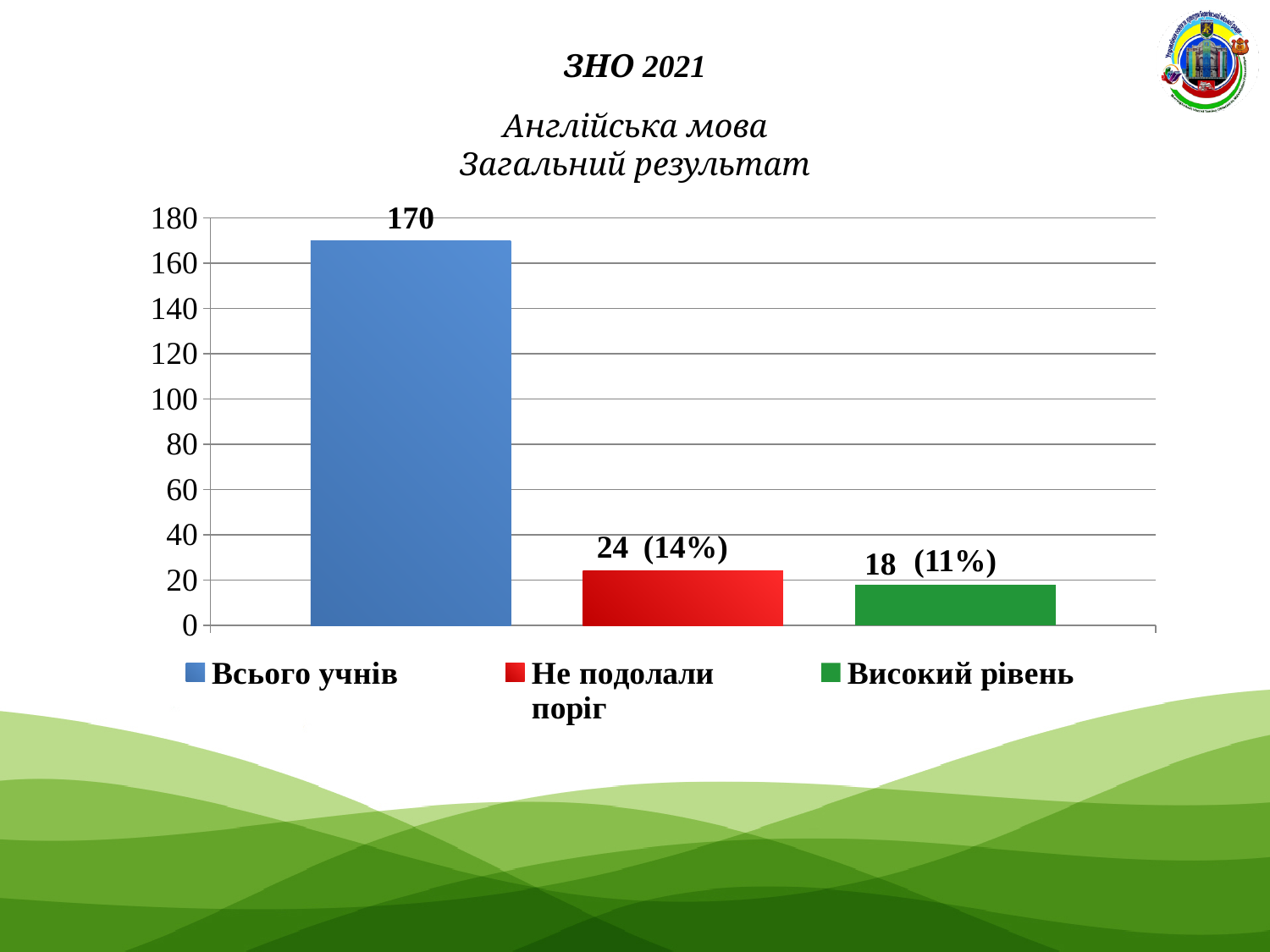
What is the difference between the values for Всього учнів and Не подолали поріг? 146 What is the data label shown on the Високий рівень bar? 18 (11%) What is the value for Всього учнів? 170 What is the difference between the values for Не подолали поріг and Високий рівень? 6 How many series does the legend list? 3 What is the data label shown on the Не подолали поріг bar? 24 (14%) What kind of chart is shown on the slide? bar chart Which series has the highest value? Всього учнів Is the value for Всього учнів greater or less than 160? greater What colour is the bar for Високий рівень? green Which series has the lowest value? Високий рівень Which is larger, the value for Не подолали поріг or the value for Високий рівень? Не подолали поріг